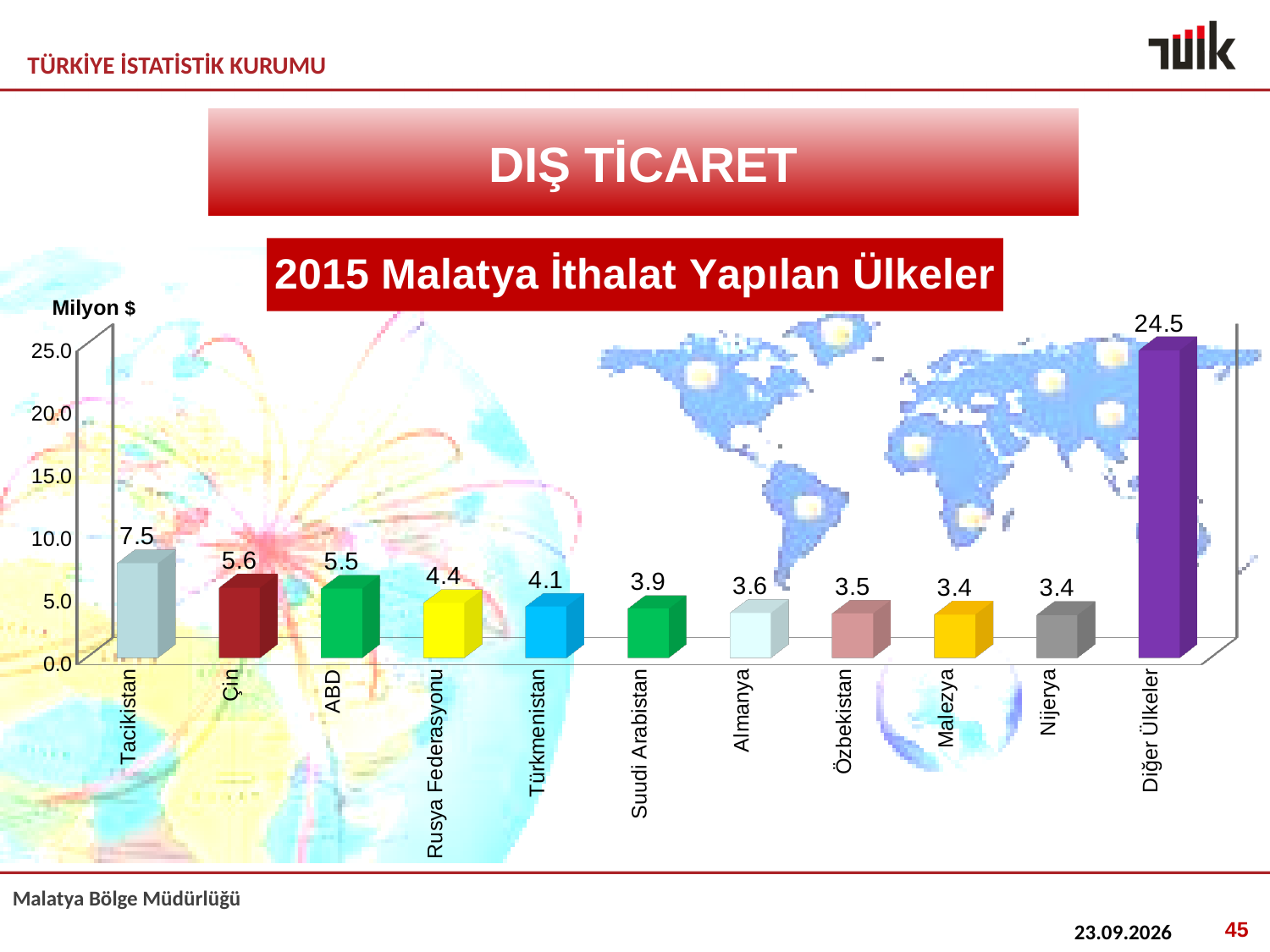
What is the value for Diğer Ülkeler? 24.5 Is the value for Diğer Ülkeler greater or less than 20.0? greater What is the value for Rusya Federasyonu? 4.4 Which category has the highest value overall? Diğer Ülkeler Which country (excluding Diğer Ülkeler) has the highest value? Tacikistan How many categories are shown on the x axis? 11 What kind of chart is shown? bar chart Which is larger, the value for ABD or the value for Türkmenistan? ABD What is the difference between the values for Tacikistan and Çin? 1.9 What unit is shown on the value axis? Milyon $ What is the title of the chart? 2015 Malatya İthalat Yapılan Ülkeler What is the value for Tacikistan? 7.5